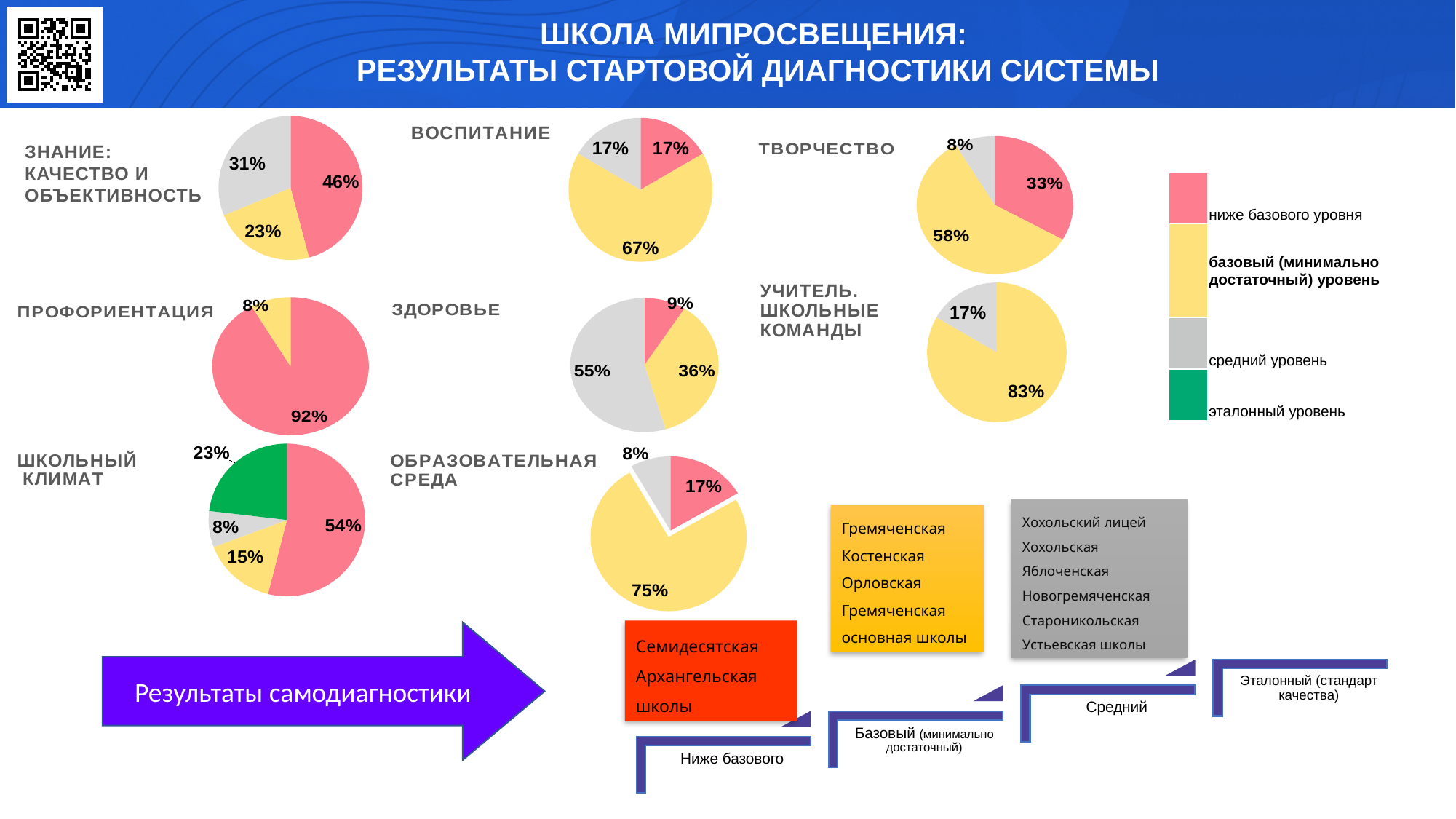
In the ОБРАЗОВАТЕЛЬНАЯ СРЕДА pie chart, which is larger: the 'ниже базового уровня' slice or the 'средний уровень' slice? ниже базового уровня In the ВОСПИТАНИЕ pie chart, what share is shown for the 'базовый (минимально достаточный) уровень' (yellow) slice? 67% In the ЗДОРОВЬЕ pie chart, which level has the smallest slice? ниже базового уровня How many levels does the legend on the right of the slide list? 4 In the ШКОЛЬНЫЙ КЛИМАТ pie chart, what share is shown for the 'эталонный уровень' (green) slice? 23% In the УЧИТЕЛЬ. ШКОЛЬНЫЕ КОМАНДЫ pie chart, what is the difference between the 'базовый' slice and the 'средний уровень' slice? 66% How many slices does the ШКОЛЬНЫЙ КЛИМАТ pie chart have? 4 In the ПРОФОРИЕНТАЦИЯ pie chart, what share is labelled for the 'ниже базового уровня' slice? 92% What type of charts are used on this slide to show the diagnostic results? Pie charts In the ЗНАНИЕ: КАЧЕСТВО И ОБЪЕКТИВНОСТЬ pie chart, what share is labelled for the 'ниже базового уровня' (pink) slice? 46% In the ТВОРЧЕСТВО pie chart, which level has the largest slice? базовый (минимально достаточный) уровень In the ЗНАНИЕ: КАЧЕСТВО И ОБЪЕКТИВНОСТЬ pie chart, what is the difference between the 'средний уровень' slice and the 'базовый' slice? 8%